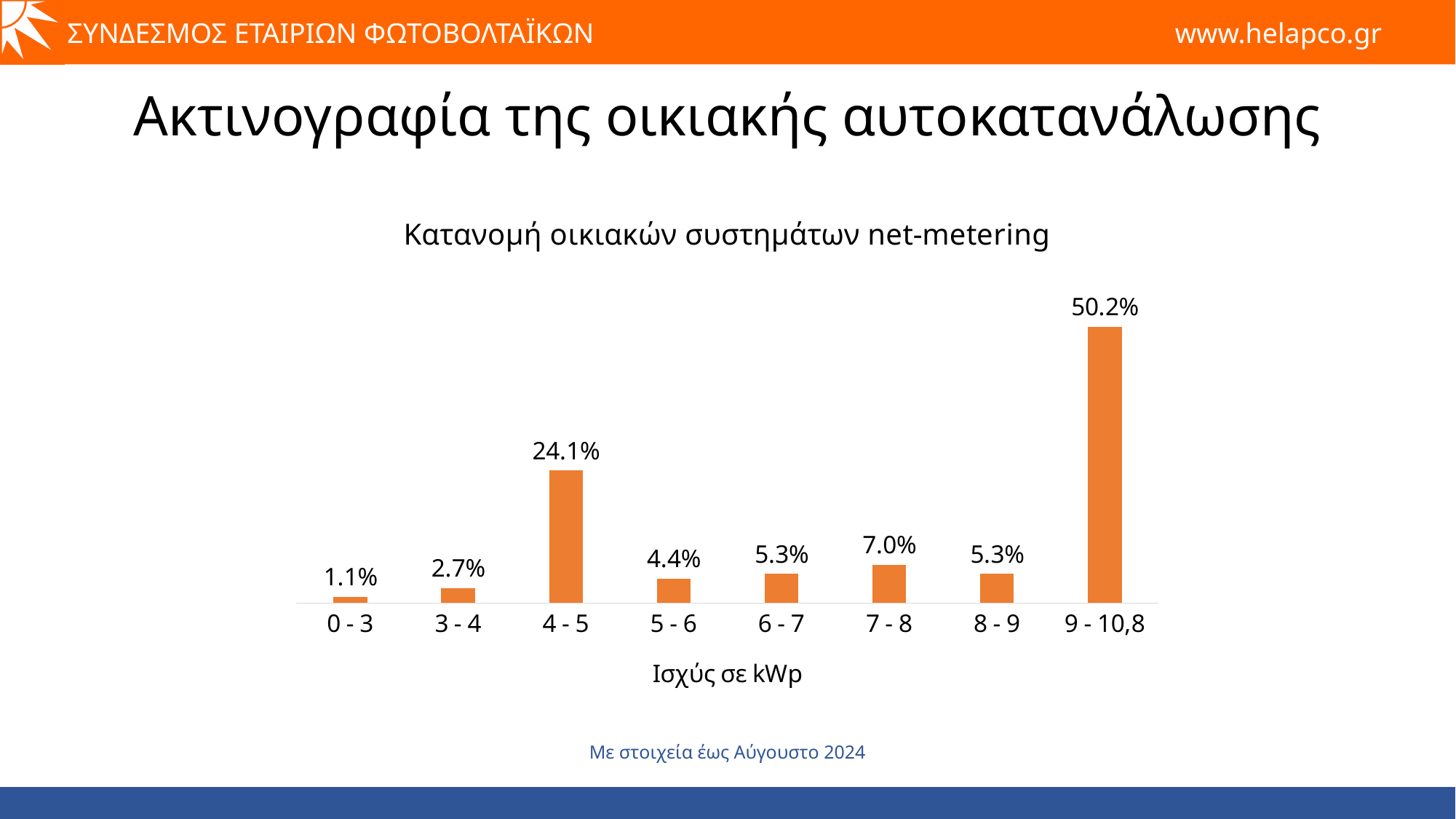
What is the value for the 7 - 8 kWp category? 7.0% What is the difference between the values for 9 - 10,8 and 4 - 5? 26.1% Which is larger, the value for 3 - 4 or the value for 5 - 6? 5 - 6 What is the title of the chart? Κατανομή οικιακών συστημάτων net-metering What kind of chart is shown on the slide? Bar chart What is the difference between the values for 7 - 8 and 5 - 6? 2.6% How many categories are shown on the x axis? 8 What is the value for the 4 - 5 kWp category? 24.1% Which category has the lowest value? 0 - 3 What is the value for the 9 - 10,8 kWp category? 50.2% Which category has the highest value? 9 - 10,8 What is the value for the 0 - 3 kWp category? 1.1%